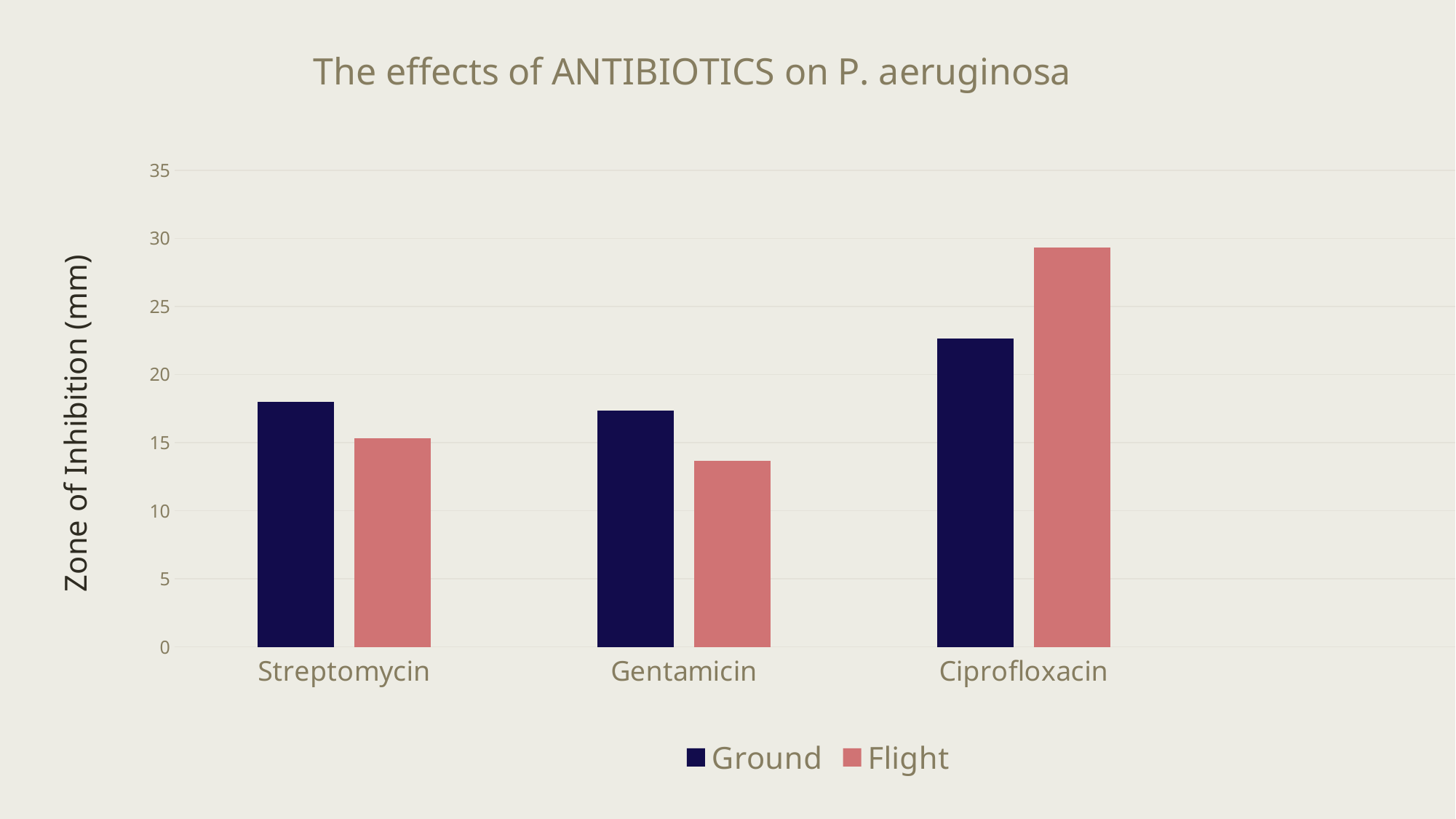
Which antibiotic has the lowest Flight value? Gentamicin For Streptomycin, which is larger, the Ground value or the Flight value? Ground What is the label of the vertical axis? Zone of Inhibition (mm) How many series does the legend list? 2 For Ciprofloxacin, which is larger, the Ground value or the Flight value? Flight Which antibiotic has the highest Flight value? Ciprofloxacin How many antibiotics are shown on the x axis? 3 What is the title of the chart? The effects of ANTIBIOTICS on P. aeruginosa Is the Ground value for Ciprofloxacin greater or less than 20? greater Which antibiotic has the highest Ground value? Ciprofloxacin What kind of chart is shown on the slide? bar chart Is the Flight value for Gentamicin greater or less than 15? less